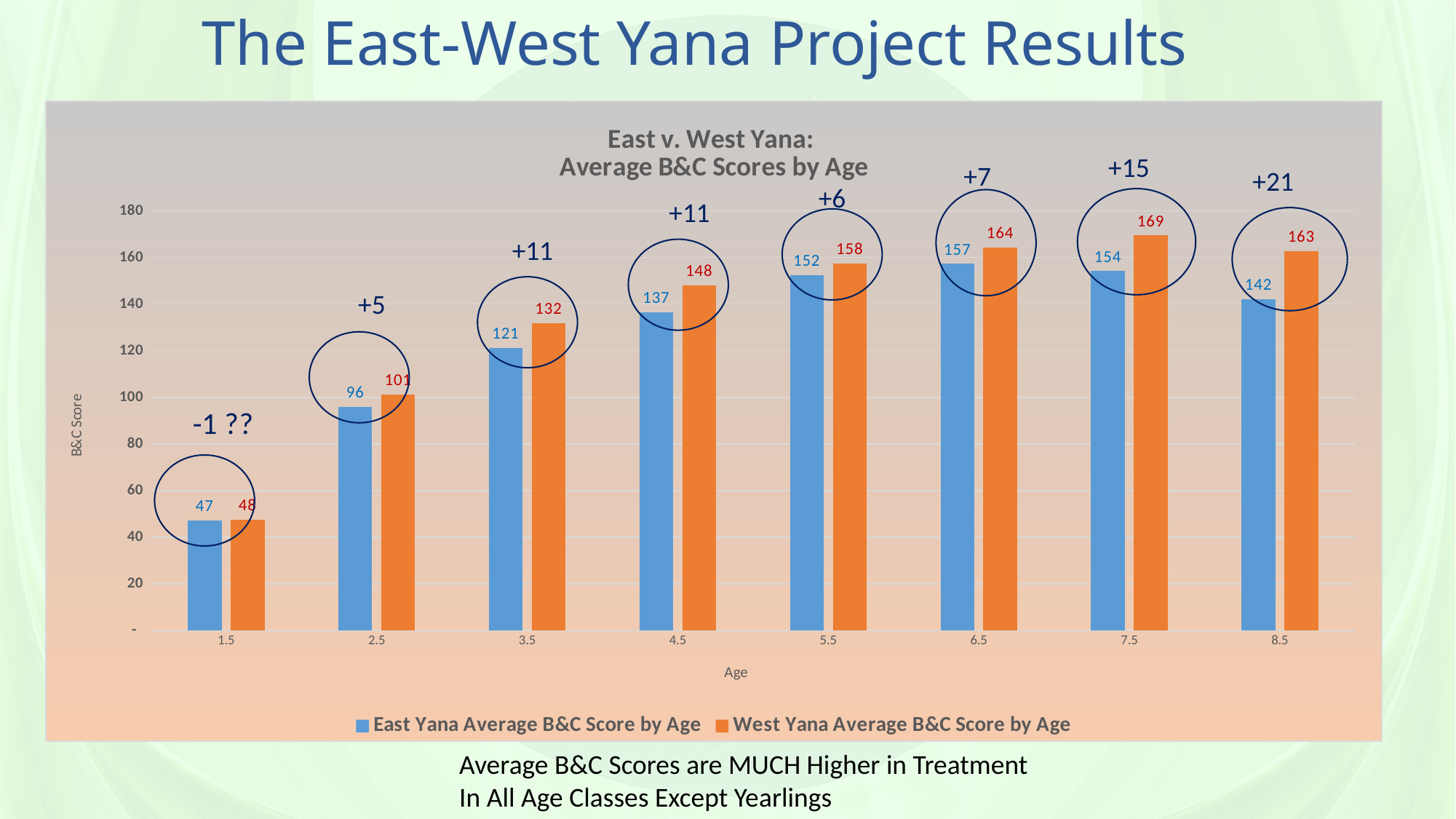
Which age class has the highest West Yana average B&C score? 7.5 What is the difference between the West Yana and East Yana average B&C scores at age 8.5? 21 What is the East Yana average B&C score for age 1.5? 47 How many age classes are shown on the x axis? 8 What is the West Yana average B&C score for age 7.5? 169 Which age class has the lowest East Yana average B&C score? 1.5 How many series does the legend list? 2 What kind of chart is shown on the slide? Bar chart Does the West Yana average B&C score rise or fall from age 1.5 to age 7.5? Rise At age 3.5, which series has the larger average B&C score, East Yana or West Yana? West Yana What is the East Yana average B&C score for age 4.5? 137 What is the title of the chart? East v. West Yana: Average B&C Scores by Age